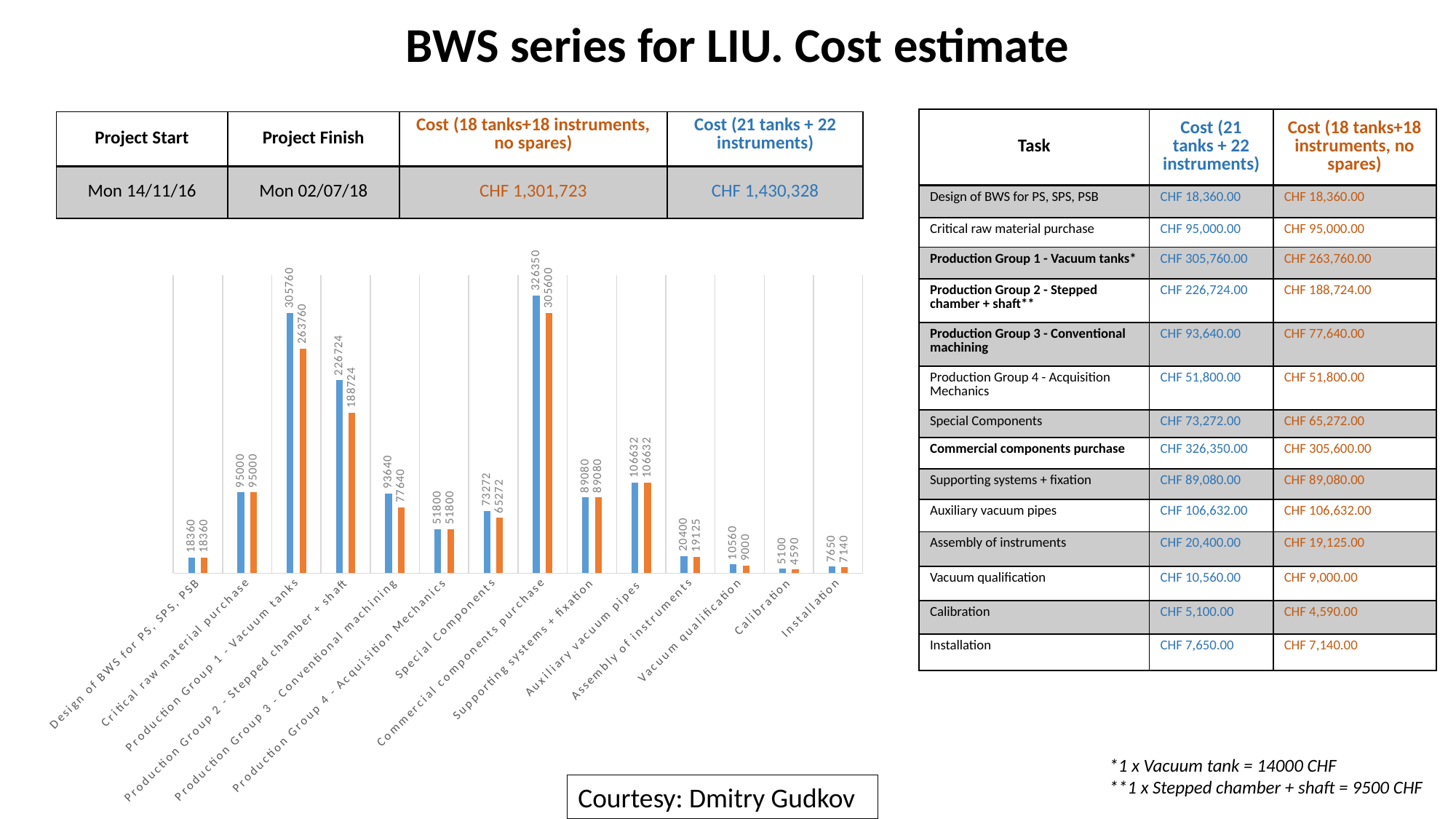
How many task categories are plotted along the x axis of the chart? 14 What is the difference between the blue and orange bars for Production Group 3 - Conventional machining? 16000 Which category has the lowest orange bar? Calibration What is the value of the blue bar for Production Group 2 - Stepped chamber + shaft? 226724 What is the difference between the blue and orange bars for Production Group 1 - Vacuum tanks? 42000 How many bars are shown for each category in the chart? 2 Which is larger, the blue bar for Auxiliary vacuum pipes or the blue bar for Supporting systems + fixation? Auxiliary vacuum pipes Which category has the highest blue bar? Commercial components purchase What is the value of the orange bar for Calibration? 4590 What kind of chart is shown on the slide? bar chart What is the value of the blue bar for Commercial components purchase? 326350 What is the value of the orange bar for Production Group 1 - Vacuum tanks? 263760